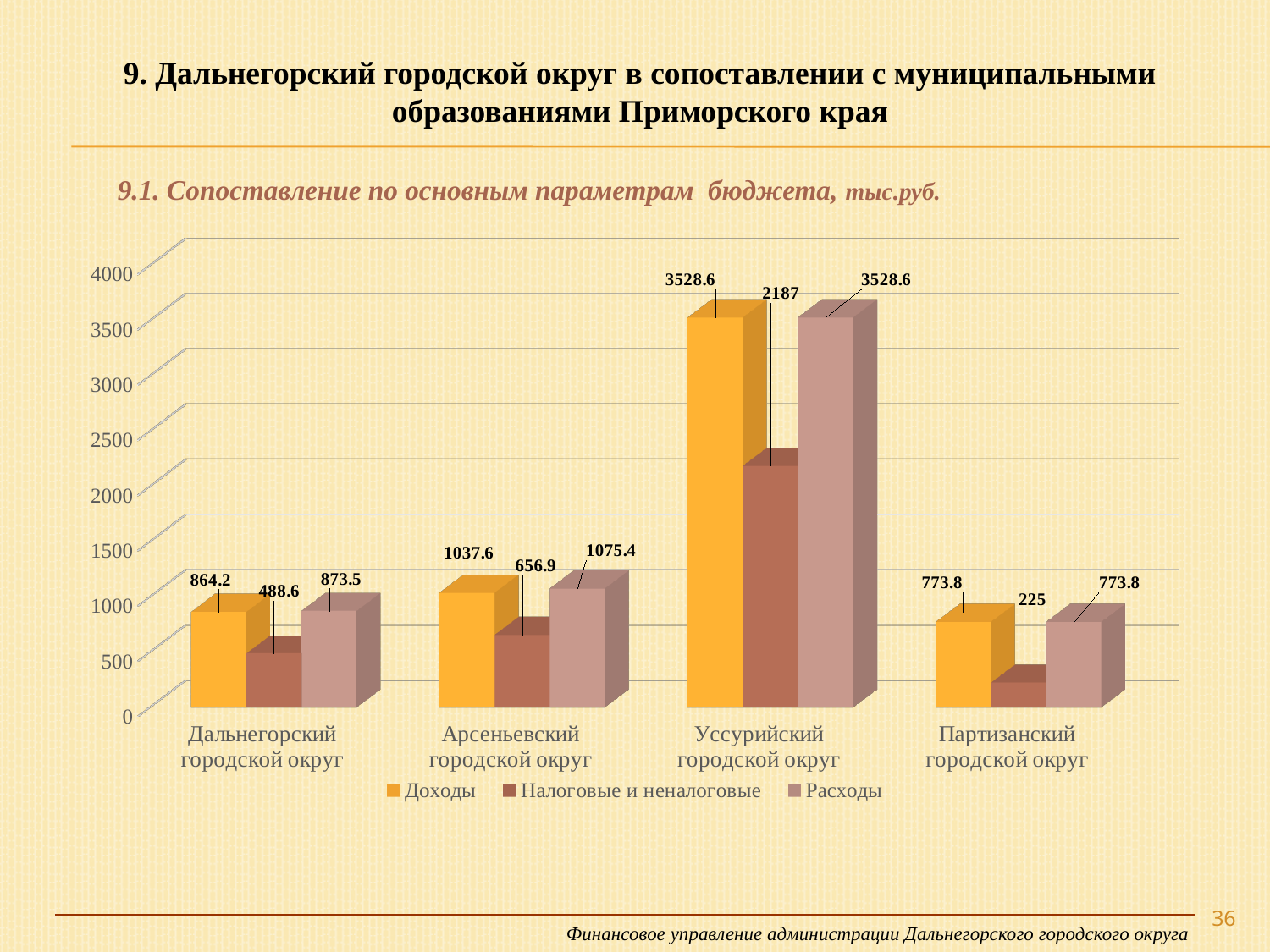
What is the value of Налоговые и неналоговые for Уссурийский городской округ? 2187 What is the value of Доходы for Дальнегорский городской округ? 864.2 Which municipality has the highest Доходы value? Уссурийский городской округ What is the value of Расходы for Арсеньевский городской округ? 1075.4 How many municipalities are shown on the x axis? 4 What is the value of Налоговые и неналоговые for Партизанский городской округ? 225 What is the difference between Расходы and Доходы for Дальнегорский городской округ? 9.3 Which series is shown in yellow-orange in the legend? Доходы Which municipality has the lowest Налоговые и неналоговые value? Партизанский городской округ Which is larger: Доходы for Арсеньевский городской округ or Доходы for Партизанский городской округ? Арсеньевский городской округ How many series does the legend list? 3 What kind of chart is shown on the slide? Bar chart